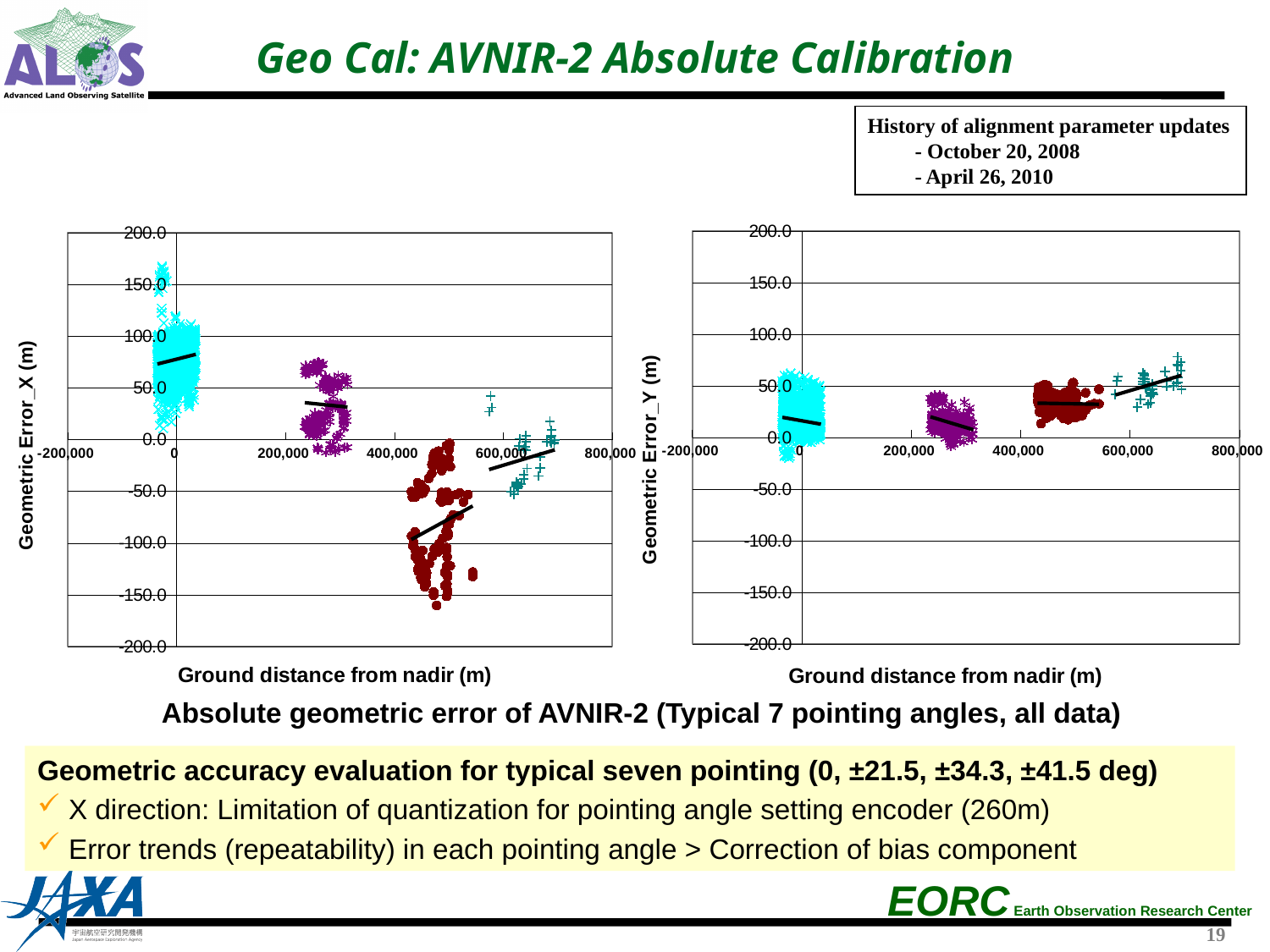
What kind of chart is the left chart on the slide? scatter chart In the left chart (Geometric Error_X), are the cyan points near 0 m ground distance mostly greater or less than 0.0? greater In the left chart (Geometric Error_X), which cluster has higher error values: the cyan cluster near 0 m or the dark red cluster near 500,000 m? the cyan cluster In the left chart (Geometric Error_X), are the dark red points near 500,000 m ground distance mostly greater or less than 0.0? less In the right chart (Geometric Error_Y), are the dark red points near 500,000 m ground distance greater or less than 100.0? less What is the y-axis label of the right chart? Geometric Error_Y (m) In the left chart (Geometric Error_X), does the fitted line through the dark red points rise or fall as ground distance increases? rise In the right chart (Geometric Error_Y), does the fitted line through the teal points near 600,000 m rise or fall as ground distance increases? rise How many charts are shown on the slide? 2 What is the y-axis label of the left chart? Geometric Error_X (m) How many distinct colour groups of points are plotted in the left chart? 4